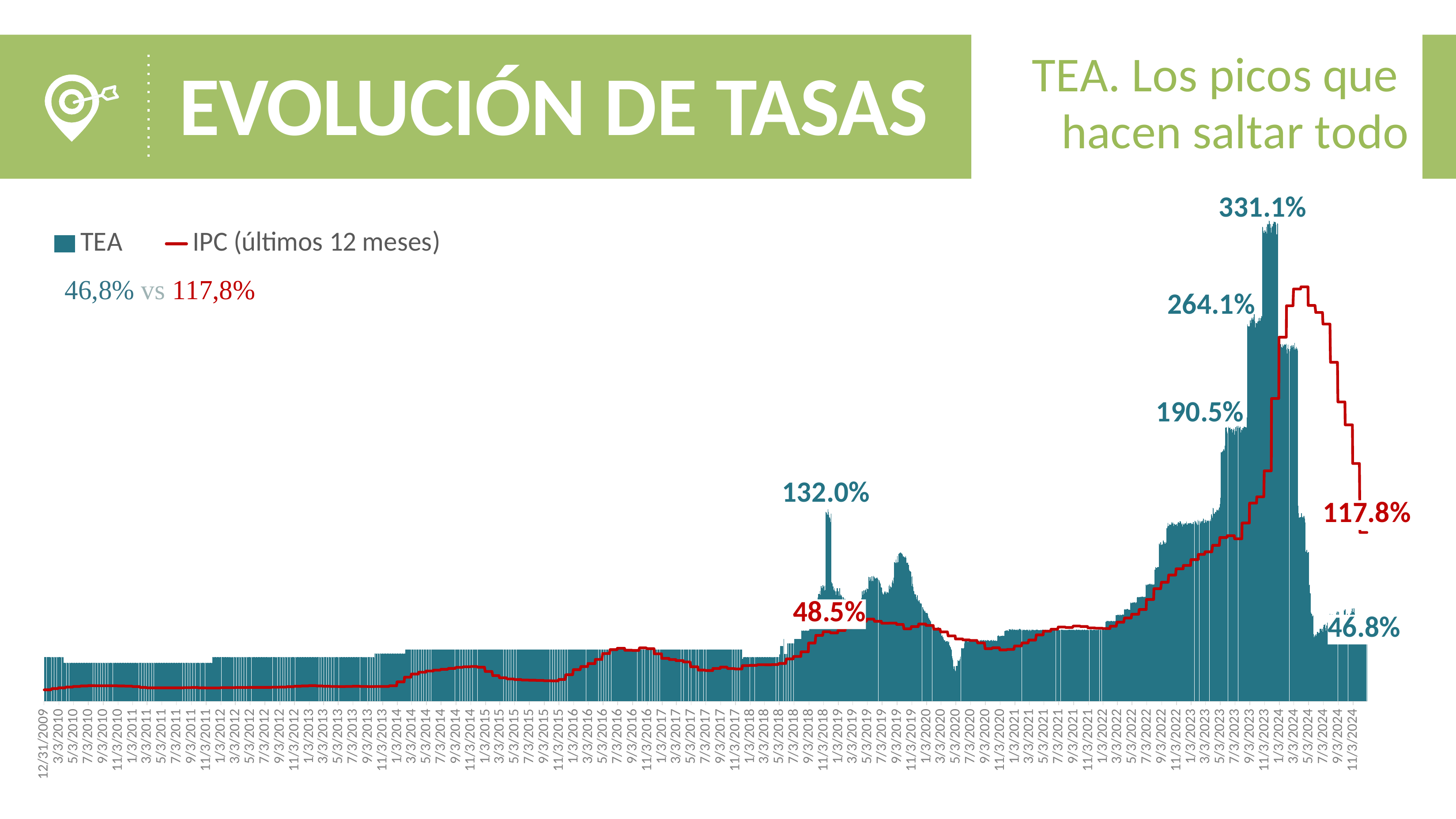
What is the difference between the final IPC value (117.8%) and the final TEA value (46.8%)? 71.0% Does the IPC line rise or fall over the final months shown in 2024? Fall What IPC value is labelled in red near early 2019? 48.5% What is the last TEA value labelled at the right end of the chart? 46.8% How many TEA peak values are labelled on the chart (excluding the final 46.8%)? 4 Which is larger at the right end of the chart, the IPC value or the TEA value? IPC What is the difference between the TEA peaks labelled 331.1% and 264.1%? 67.0% What colour is the IPC (últimos 12 meses) line? Red How many series does the legend list? 2 What is the last IPC (últimos 12 meses) value labelled at the right end of the chart? 117.8% What kind of chart is shown on the slide? Bar chart with a line overlay What is the highest TEA value labelled on the chart? 331.1%